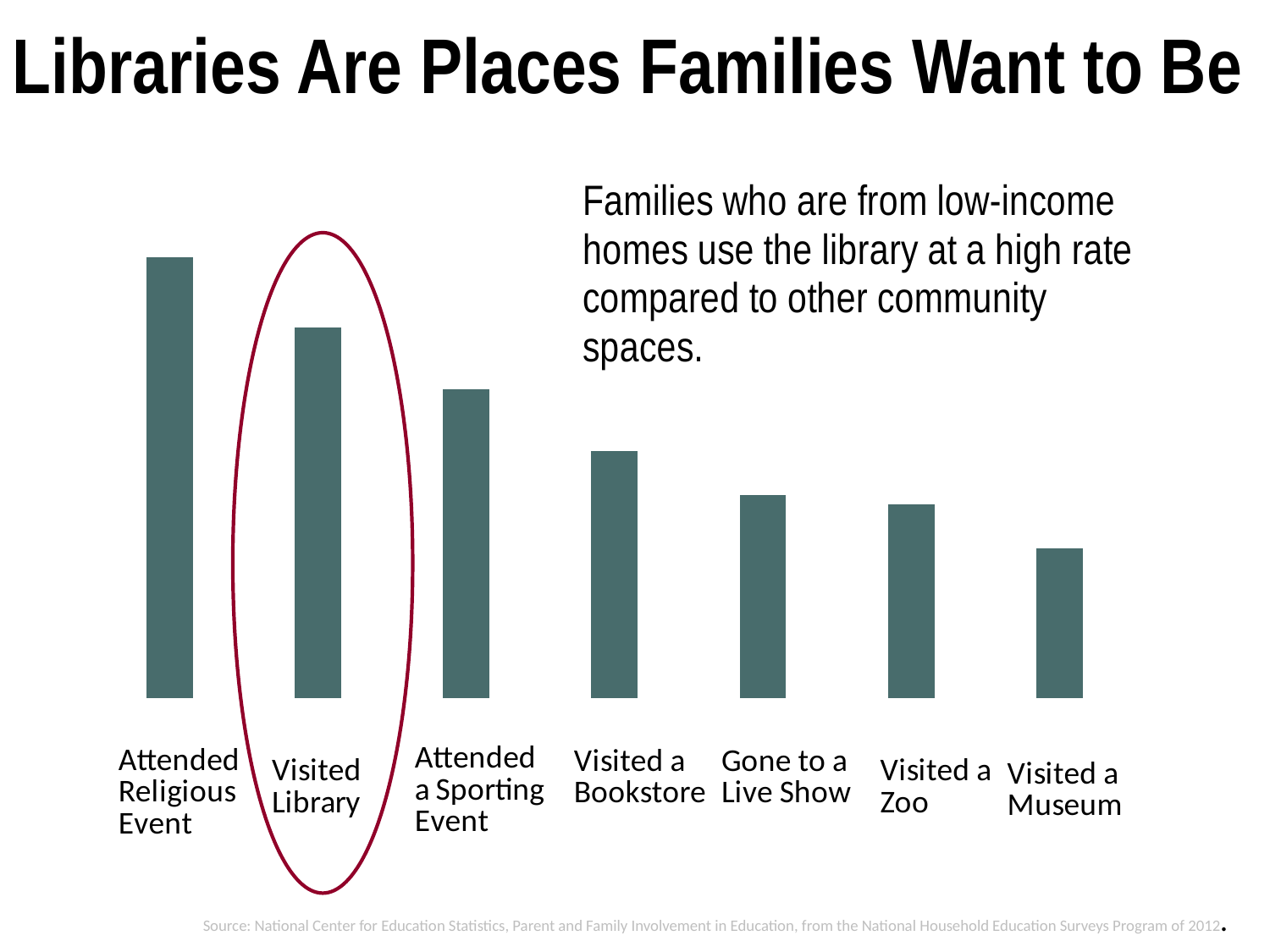
Which is larger, the bar for Visited Library or the bar for Attended a Sporting Event? Visited Library Which category's bar is circled on the slide? Visited Library Which category has the shortest bar? Visited a Museum Which is larger, the bar for Gone to a Live Show or the bar for Visited a Museum? Gone to a Live Show What kind of chart is shown on the slide? bar chart How many categories are plotted in the bar chart? 7 Which category has the tallest bar? Attended Religious Event What is the title of the slide containing the chart? Libraries Are Places Families Want to Be Do the bar heights rise or fall from left to right across the categories? fall Which category has the second tallest bar? Visited Library Which is larger, the bar for Visited a Bookstore or the bar for Visited a Zoo? Visited a Bookstore